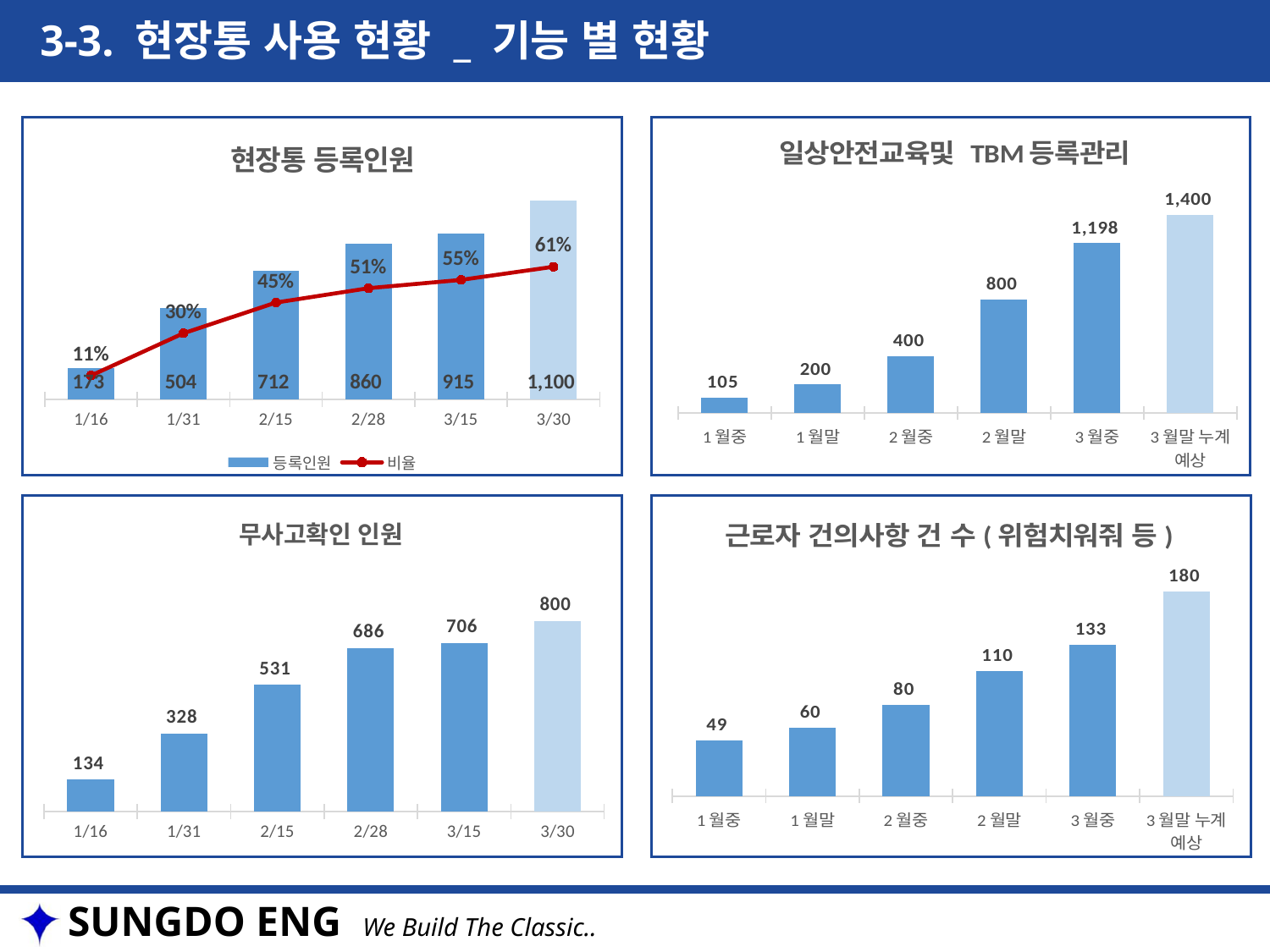
In the top-right chart (일상안전교육및 TBM 등록관리), what is the value for 3 월중? 1,198 In the top-right chart (일상안전교육및 TBM 등록관리), which category has the lowest value? 1 월중 In the bottom-left chart (무사고확인 인원), what is the value for 2/15? 531 What kind of chart is the bottom-right chart (근로자 건의사항 건 수)? bar chart In the top-left chart (현장통 등록인원), what is the 비율 value for 3/30? 61% In the bottom-left chart (무사고확인 인원), which is larger, the value for 2/28 or the value for 1/31? 2/28 In the top-left chart (현장통 등록인원), what is the 등록인원 value for 2/28? 860 In the bottom-right chart (근로자 건의사항 건 수), what is the value for 2 월말? 110 In the bottom-left chart (무사고확인 인원), how many categories are shown on the x axis? 6 How many series does the legend of the top-left chart (현장통 등록인원) list? 2 In the top-left chart (현장통 등록인원), does the 비율 line rise or fall from 1/16 to 3/30? rise In the top-right chart (일상안전교육및 TBM 등록관리), what is the difference between the values for 2 월말 and 2 월중? 400